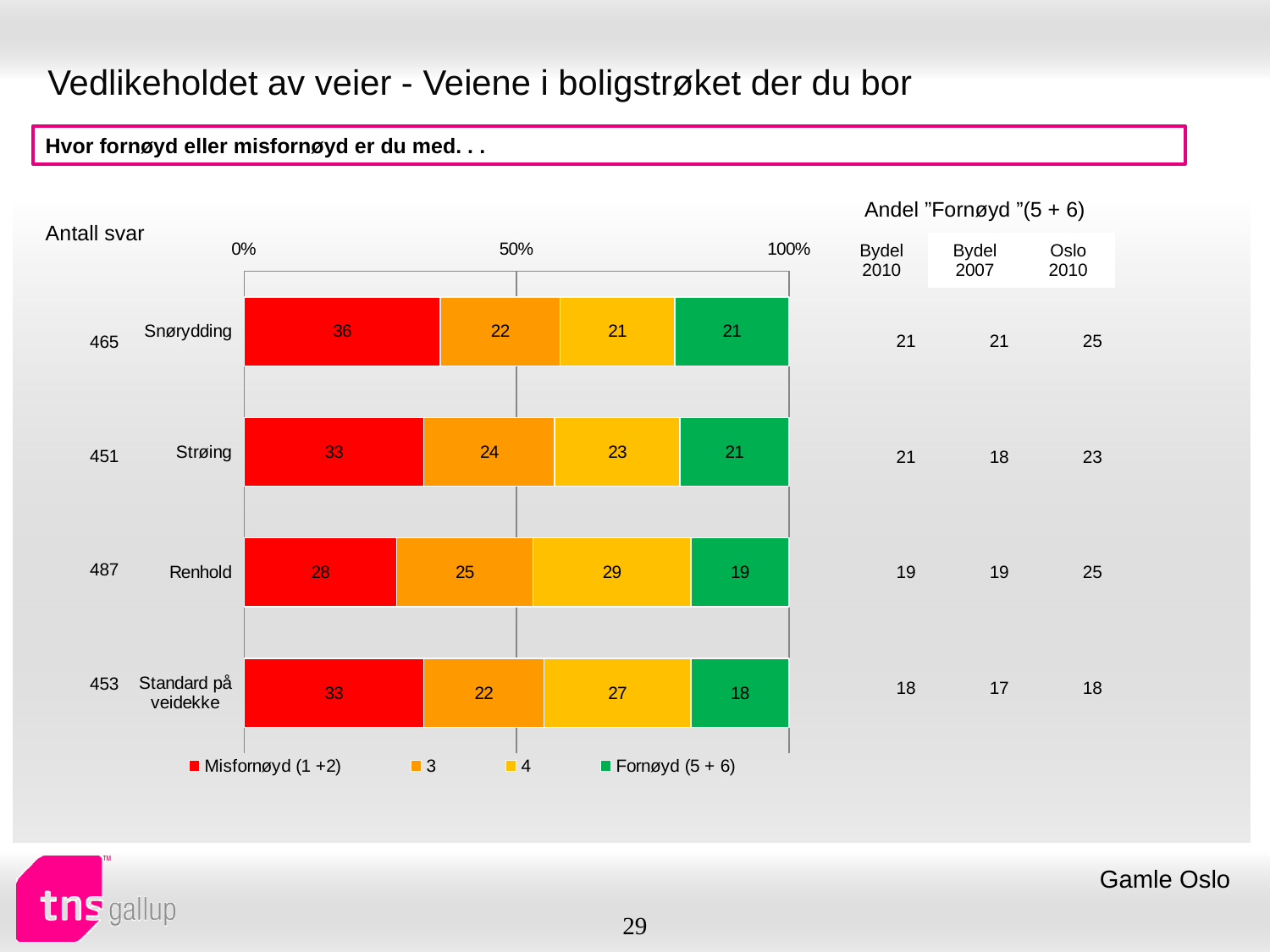
Which is larger: the series 4 value for Renhold or for Snørydding? Renhold Which legend entry is shown in green? Fornøyd (5 + 6) What is the difference between the Misfornøyd (1 +2) values for Snørydding and Renhold? 8 What kind of chart is shown on the slide? stacked bar chart What is the Fornøyd (5 + 6) value for Renhold? 19 What is the value of series 3 for Strøing? 24 What is the value of series 4 for Standard på veidekke? 27 How many series does the legend list? 4 What is the Misfornøyd (1 +2) value for Snørydding? 36 How many categories are plotted in the chart? 4 Which category has the highest Misfornøyd (1 +2) value? Snørydding Which category has the lowest Fornøyd (5 + 6) value? Standard på veidekke